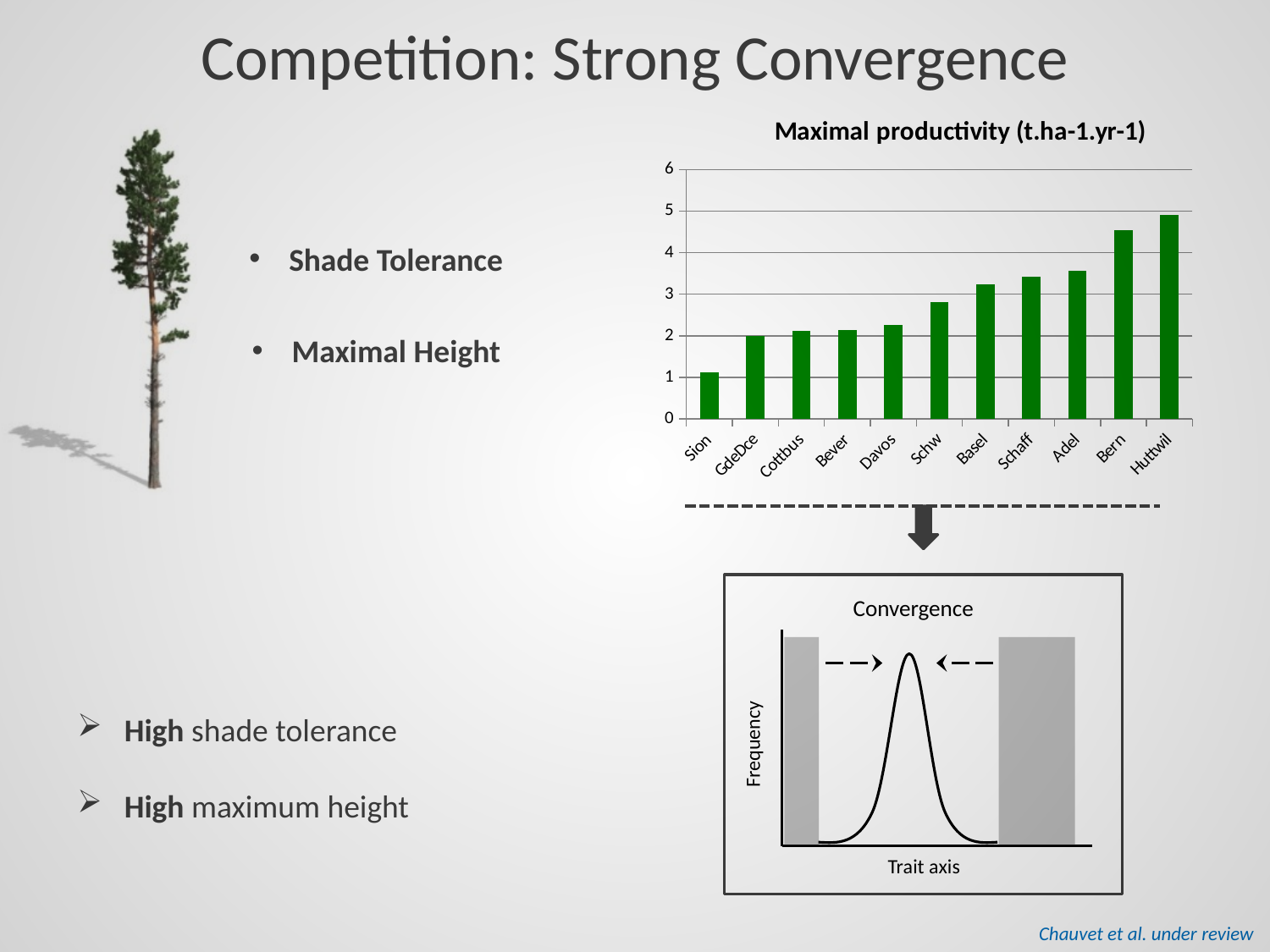
In the 'Maximal productivity (t.ha-1.yr-1)' chart, is the value for Schw greater or less than 3? less In the 'Maximal productivity (t.ha-1.yr-1)' chart, is the value for Sion greater or less than 2? less In the 'Maximal productivity (t.ha-1.yr-1)' chart, which site has the lowest value? Sion What is the title of the bar chart on the slide? Maximal productivity (t.ha-1.yr-1) In the 'Maximal productivity (t.ha-1.yr-1)' chart, which site has the highest value? Huttwil What kind of chart is the 'Maximal productivity (t.ha-1.yr-1)' chart? bar chart In the 'Maximal productivity (t.ha-1.yr-1)' chart, which has the larger value, Bern or Basel? Bern How many sites are shown on the x axis of the 'Maximal productivity (t.ha-1.yr-1)' chart? 11 In the 'Maximal productivity (t.ha-1.yr-1)' chart, is the value for Huttwil greater or less than 4? greater In the 'Maximal productivity (t.ha-1.yr-1)' chart, do the values rise or fall from Sion to Huttwil along the x axis? rise In the 'Maximal productivity (t.ha-1.yr-1)' chart, which has the larger value, Sion or Davos? Davos